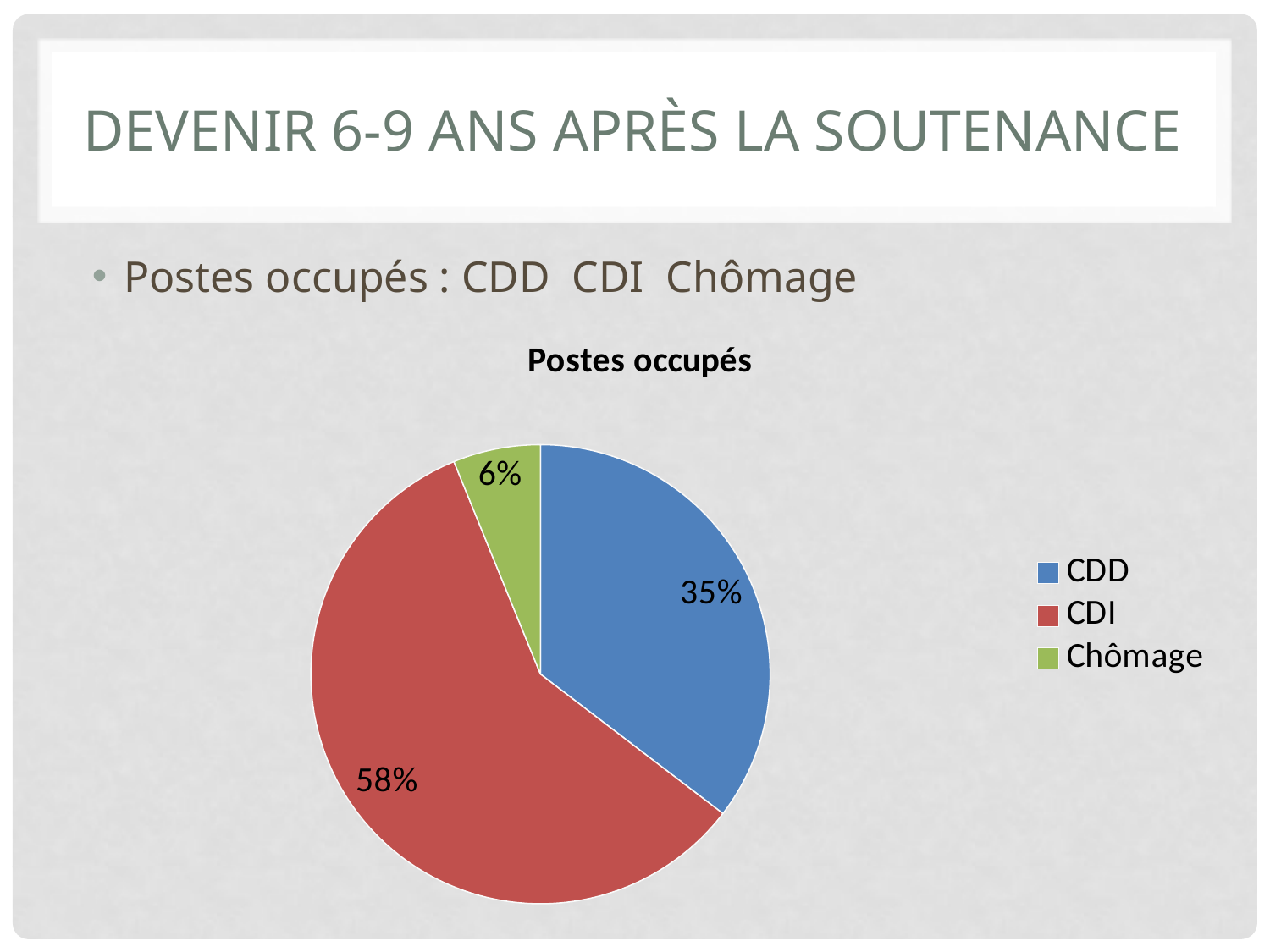
Which colour represents CDI in the pie chart? Red What is the difference in percentage points between the CDI and CDD slices? 23 Which category has the smallest slice of the pie? Chômage Which is larger, the CDD slice or the Chômage slice? CDD What is the difference in percentage points between the CDD and Chômage slices? 29 What share of the pie does CDI represent? 58% What share of the pie does Chômage represent? 6% What is the title of the chart? Postes occupés Which category has the largest slice of the pie? CDI What kind of chart is shown on the slide? Pie chart What share of the pie does CDD represent? 35% How many categories are shown in the pie chart? 3